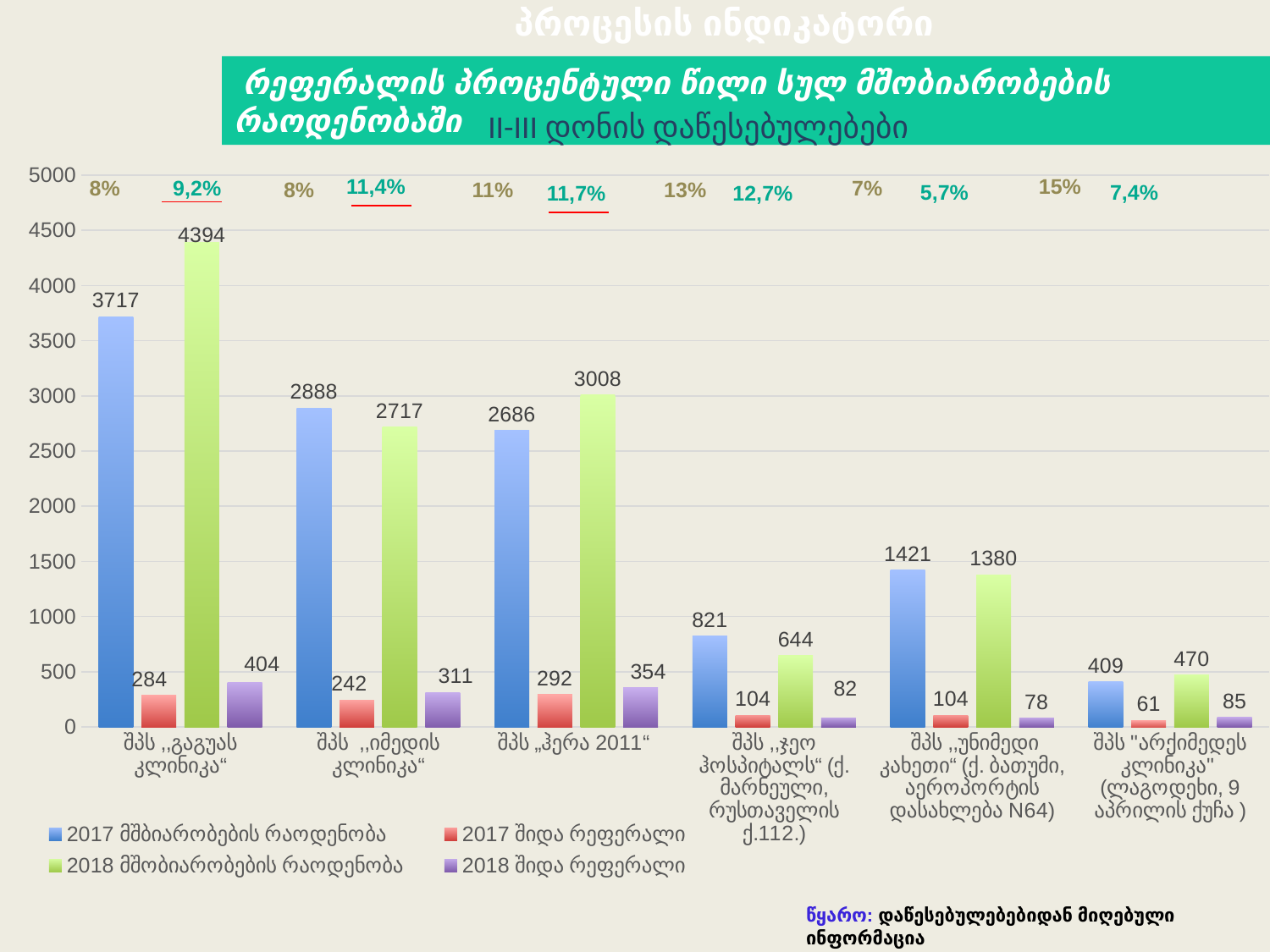
Which clinic has the highest value of 2017 მშობიარობების რაოდენობა? შპს „გაგუას კლინიკა“ What is the value of 2017 მშობიარობების რაოდენობა for შპს „ჯეო ჰოსპიტალს“? 821 What is the value of 2017 შიდა რეფერალი for შპს „იმედის კლინიკა“? 242 How many clinics (categories) are shown on the x axis? 6 Which clinic has the lowest value of 2018 მშობიარობების რაოდენობა? შპს „არქიმედეს კლინიკა“ How many series does the legend list? 4 Which is larger for შპს „უნიმედი კახეთი“: the 2017 მშობიარობების რაოდენობა or the 2018 მშობიარობების რაოდენობა? 2017 მშობიარობების რაოდენობა What is the value of 2018 მშობიარობების რაოდენობა for შპს „გაგუას კლინიკა“? 4394 What percentage is printed above the 2018 bars for შპს „იმედის კლინიკა“? 11,4% What type of chart is shown on the slide? bar chart